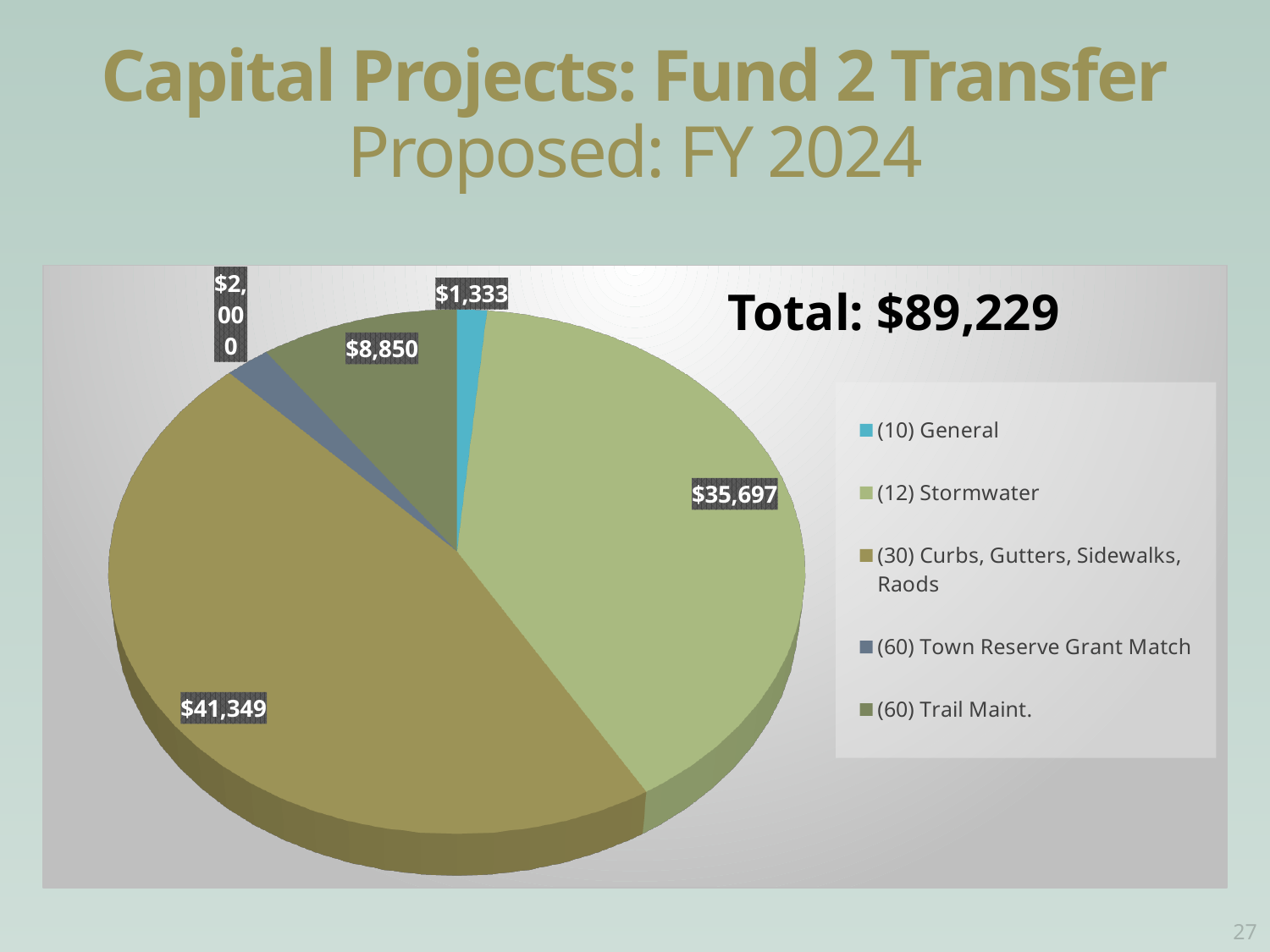
What is the value for (12) Stormwater? $35,697 Which is larger, the value for (60) Trail Maint. or the value for (60) Town Reserve Grant Match? (60) Trail Maint. Which category has the smallest slice of the pie? (10) General How many categories does the legend list? 5 What is the difference between the values for (30) Curbs, Gutters, Sidewalks, Raods and (12) Stormwater? $5,652 What kind of chart is shown on the slide? Pie chart What total is printed on the chart? $89,229 Which category has the largest slice of the pie? (30) Curbs, Gutters, Sidewalks, Raods What is the value for (60) Trail Maint.? $8,850 What is the value for (10) General? $1,333 What is the value for (60) Town Reserve Grant Match? $2,000 What is the value for (30) Curbs, Gutters, Sidewalks, Raods? $41,349